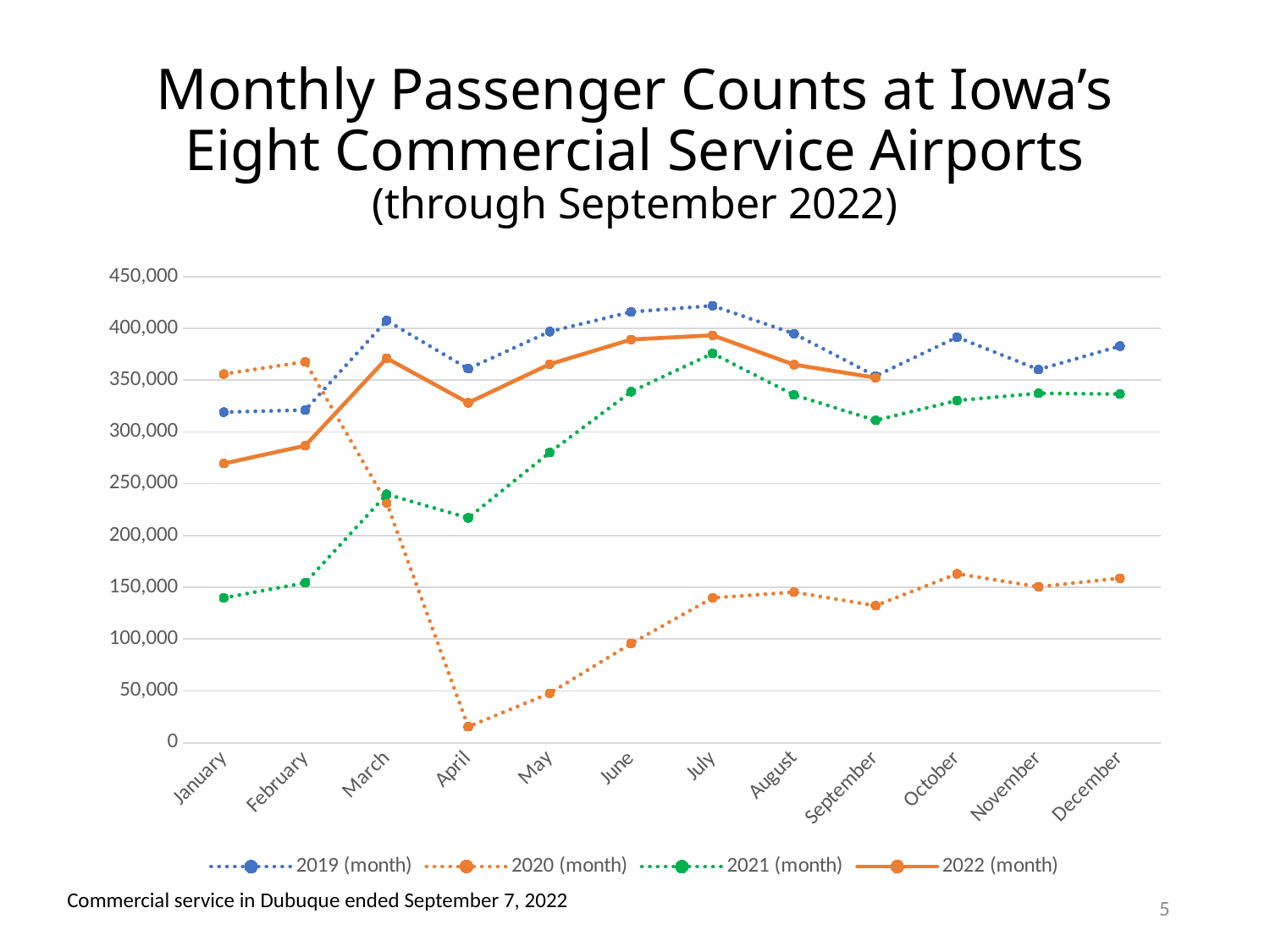
Is the value for June in the 2022 (month) series greater or less than 350,000? greater Which is larger in July: the 2019 (month) value or the 2021 (month) value? 2019 (month) Is the value for April in the 2020 (month) series greater or less than 50,000? less How many months are shown along the x axis? 12 In which month does the 2020 (month) series reach its lowest value? April In which month does the 2019 (month) series reach its highest value? July What kind of chart is shown on the slide? line chart How many series does the legend list? 4 In which month does the 2021 (month) series reach its highest value? July Which is larger in February: the 2019 (month) value or the 2020 (month) value? 2020 (month) Does the 2021 (month) series rise or fall from January to July? rise Through which month does the 2022 (month) series have data points? September